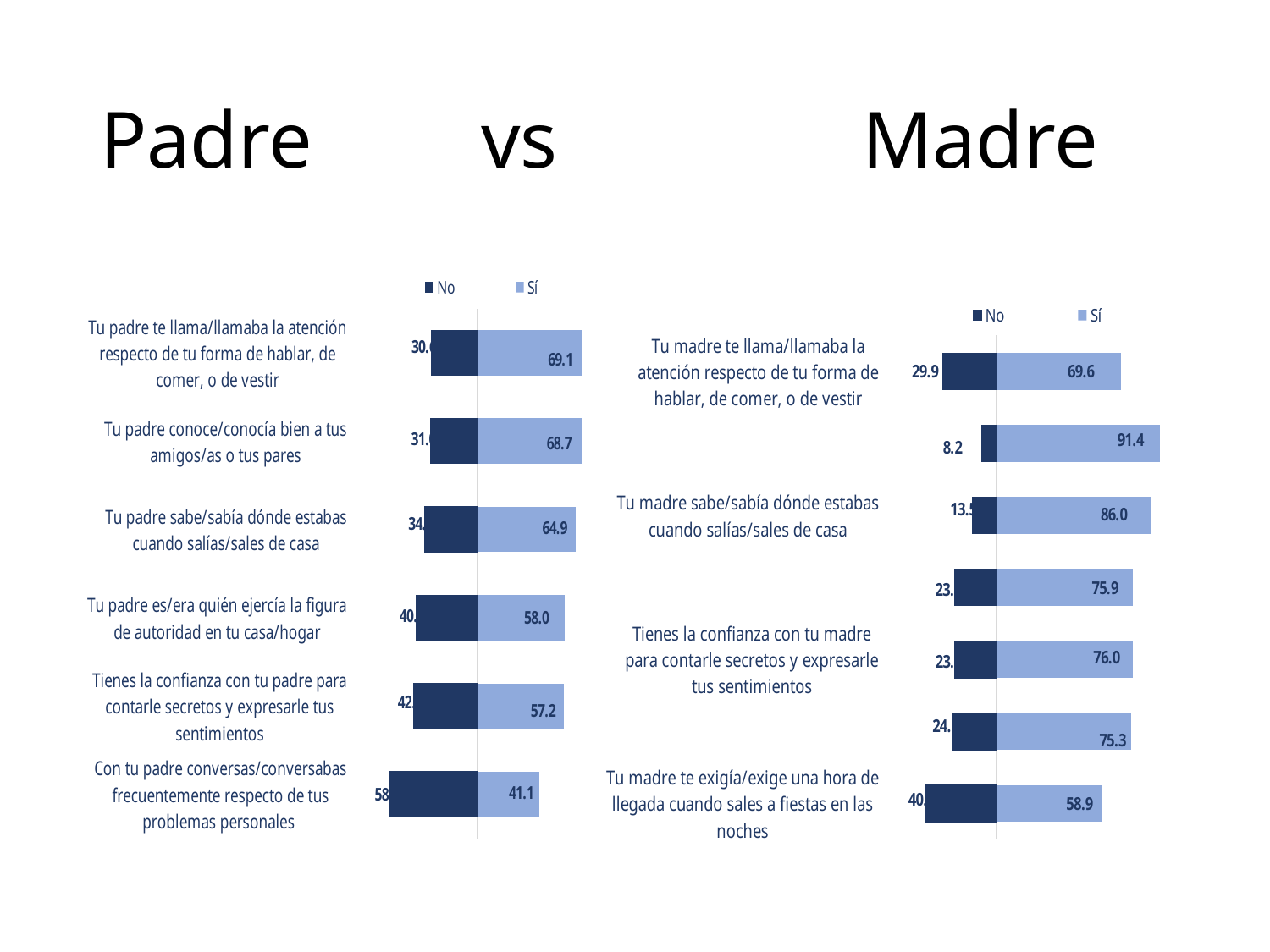
In the Padre chart on the left, what is the Sí value for "Tu padre conoce/conocía bien a tus amigos/as o tus pares"? 68.7 In the Madre chart on the right, what is the No value for "Tu madre te llama/llamaba la atención respecto de tu forma de hablar, de comer, o de vestir"? 29.9 In the Padre chart on the left, which category has the highest Sí value? Tu padre te llama/llamaba la atención respecto de tu forma de hablar, de comer, o de vestir How many categories are shown in the Padre chart on the left? 6 In the Madre chart on the right, what is the Sí value for "Tu madre te exigía/exige una hora de llegada cuando sales a fiestas en las noches"? 58.9 What kind of chart is the Padre chart on the left? bar chart In the Padre chart on the left, what is the difference between the Sí values for "Tu padre te llama/llamaba la atención respecto de tu forma de hablar, de comer, o de vestir" and "Con tu padre conversas/conversabas frecuentemente respecto de tus problemas personales"? 28.0 Which is larger: the Sí value for "Tu padre sabe/sabía dónde estabas cuando salías/sales de casa" in the Padre chart or the Sí value for "Tu madre sabe/sabía dónde estabas cuando salías/sales de casa" in the Madre chart? Tu madre sabe/sabía dónde estabas cuando salías/sales de casa In the Padre chart on the left, what is the Sí value for "Con tu padre conversas/conversabas frecuentemente respecto de tus problemas personales"? 41.1 How many series does the legend of the Padre chart on the left list? 2 In the Padre chart on the left, which category has the lowest Sí value? Con tu padre conversas/conversabas frecuentemente respecto de tus problemas personales In the Madre chart on the right, what is the Sí value for "Tu madre te llama/llamaba la atención respecto de tu forma de hablar, de comer, o de vestir"? 69.6